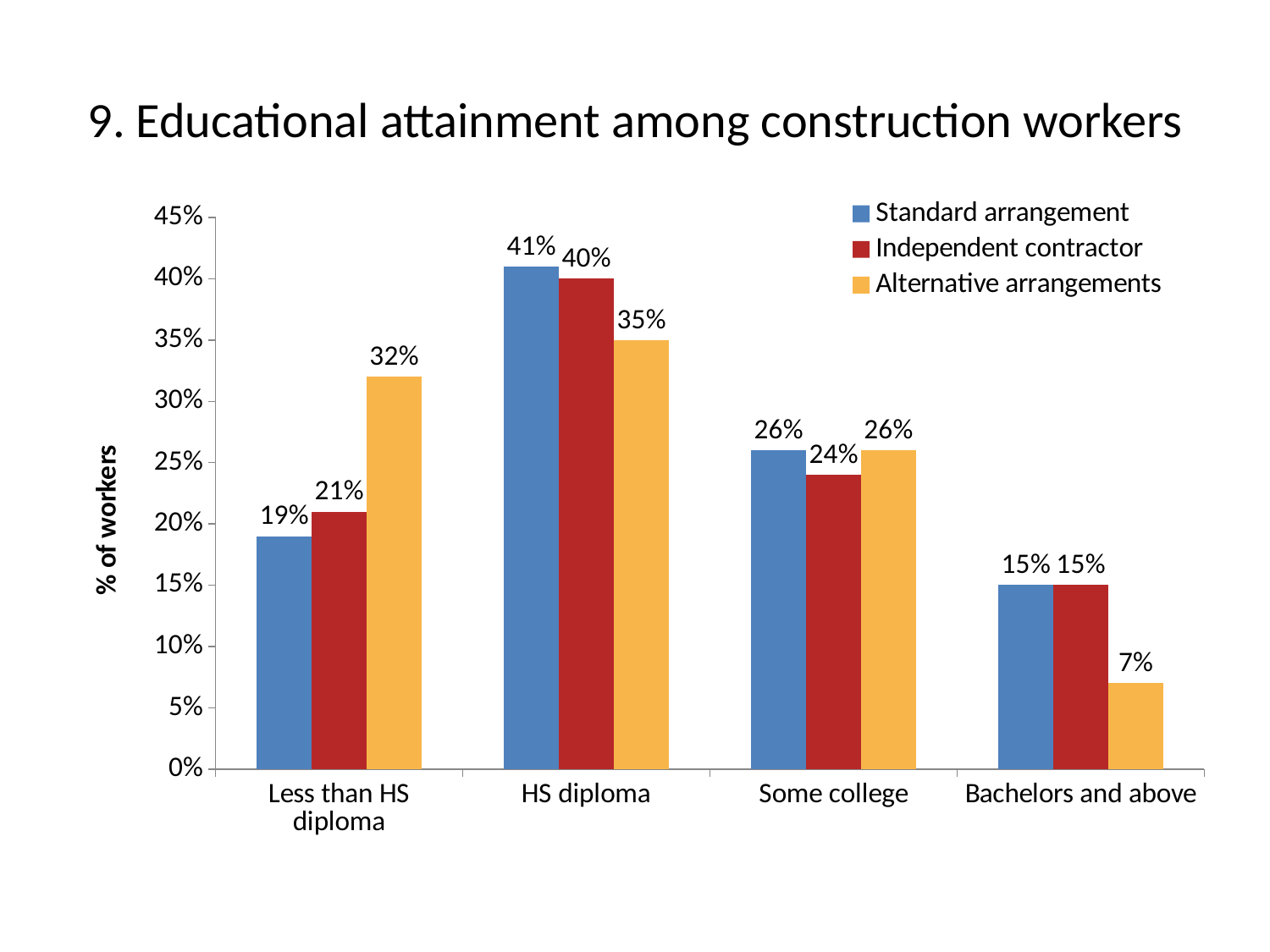
What is the label of the y axis? % of workers What percentage of Independent contractor workers have Some college? 24% What is the difference between Standard arrangement and Alternative arrangements in the Bachelors and above category? 8% How many series does the legend list? 3 Which series is shown in yellow? Alternative arrangements What kind of chart is shown on the slide? Bar chart Which education category has the lowest value for Standard arrangement? Bachelors and above In the Less than HS diploma category, which is larger: Independent contractor or Alternative arrangements? Alternative arrangements What percentage of workers in Standard arrangement have a HS diploma? 41% How many education categories are shown on the x axis? 4 Which education category has the highest value for Alternative arrangements? HS diploma What is the value for Alternative arrangements in the Less than HS diploma category? 32%